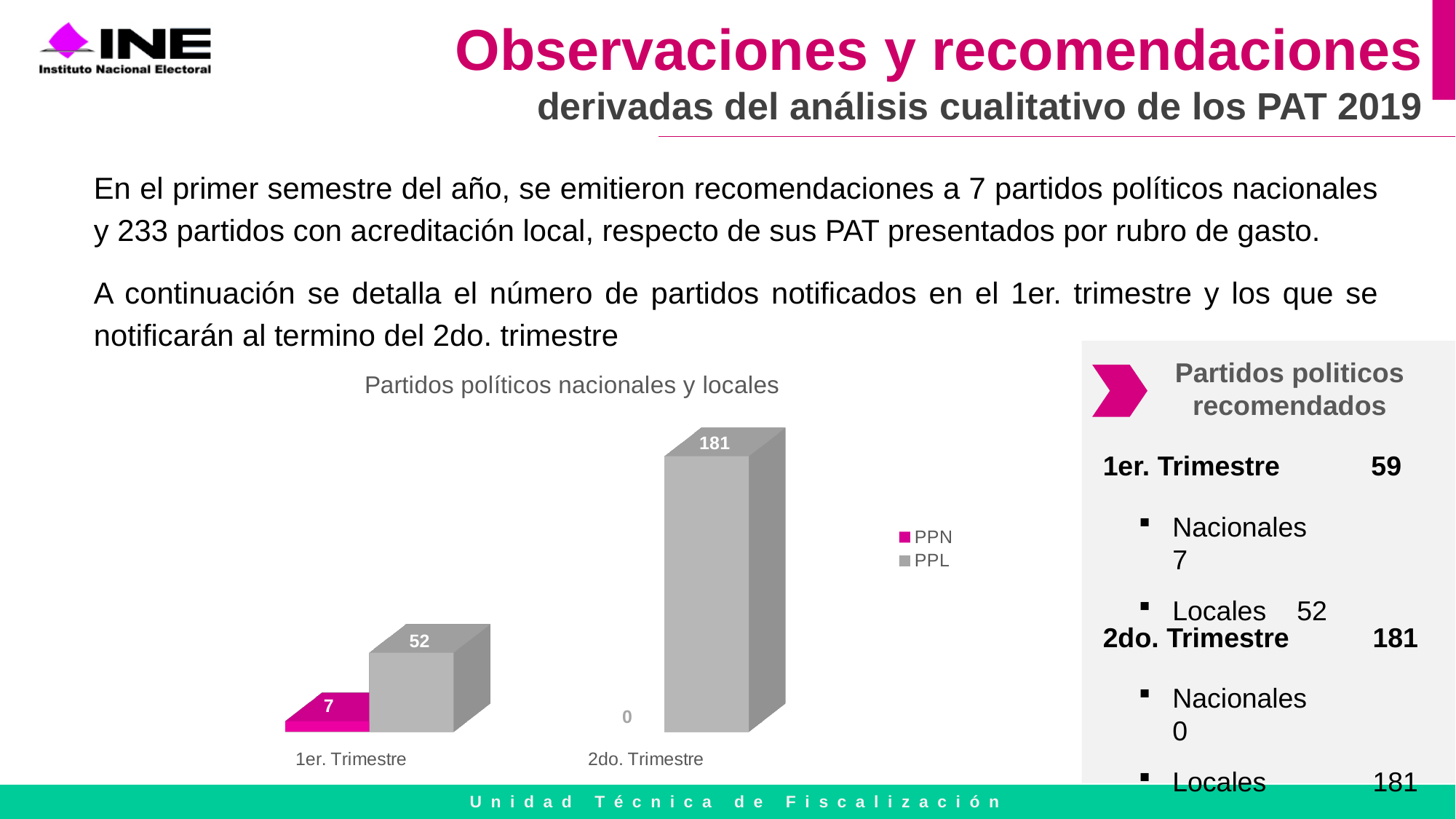
What is the value for PPL in the 1er. Trimestre? 52 What is the value for PPN in the 2do. Trimestre? 0 What kind of chart is shown? bar chart What is the title of the chart? Partidos políticos nacionales y locales Which category has the lowest PPN value? 2do. Trimestre What is the value for PPN in the 1er. Trimestre? 7 Which category has the highest PPL value? 2do. Trimestre How many series does the legend list? 2 What is the value for PPL in the 2do. Trimestre? 181 Which is larger in the 1er. Trimestre, PPN or PPL? PPL What is the difference between the PPL values for the 2do. Trimestre and the 1er. Trimestre? 129 How many categories are shown on the x axis? 2